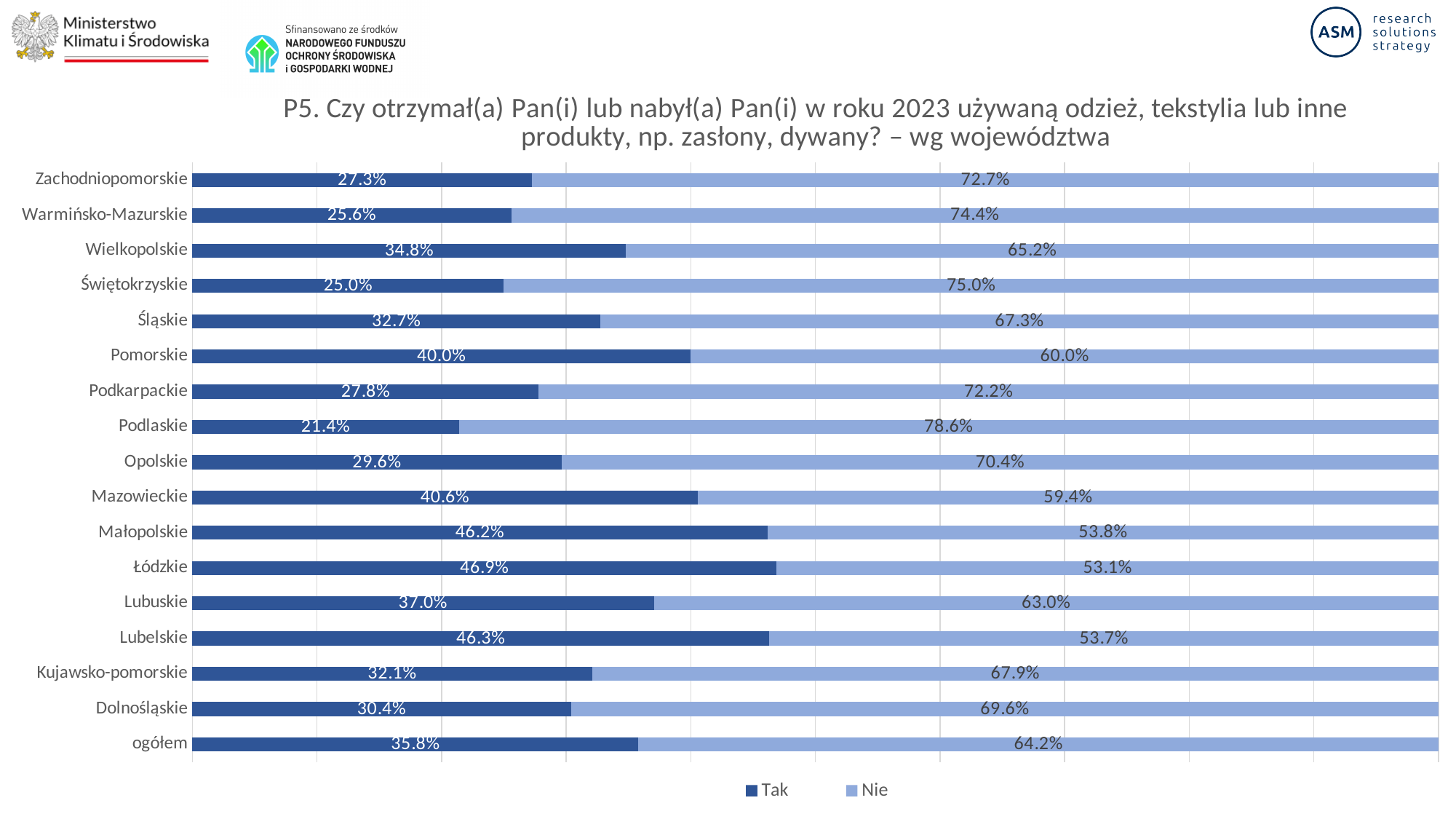
What kind of chart is shown on the slide? Stacked bar chart What is the "Tak" value for ogółem? 35.8% How many series does the legend list? 2 What is the total of the stacked bar for Zachodniopomorskie? 100.0% What is the difference between the "Tak" values for Pomorskie and Podlaskie? 18.6 percentage points What is the "Nie" value for Podlaskie? 78.6% Which has a larger "Tak" value, Mazowieckie or Dolnośląskie? Mazowieckie Which category has the lowest "Tak" value? Podlaskie How many categories are shown on the chart? 17 What is the "Tak" value for Pomorskie? 40.0% Which category has the highest "Tak" value? Łódzkie Which category has the highest "Nie" value? Podlaskie